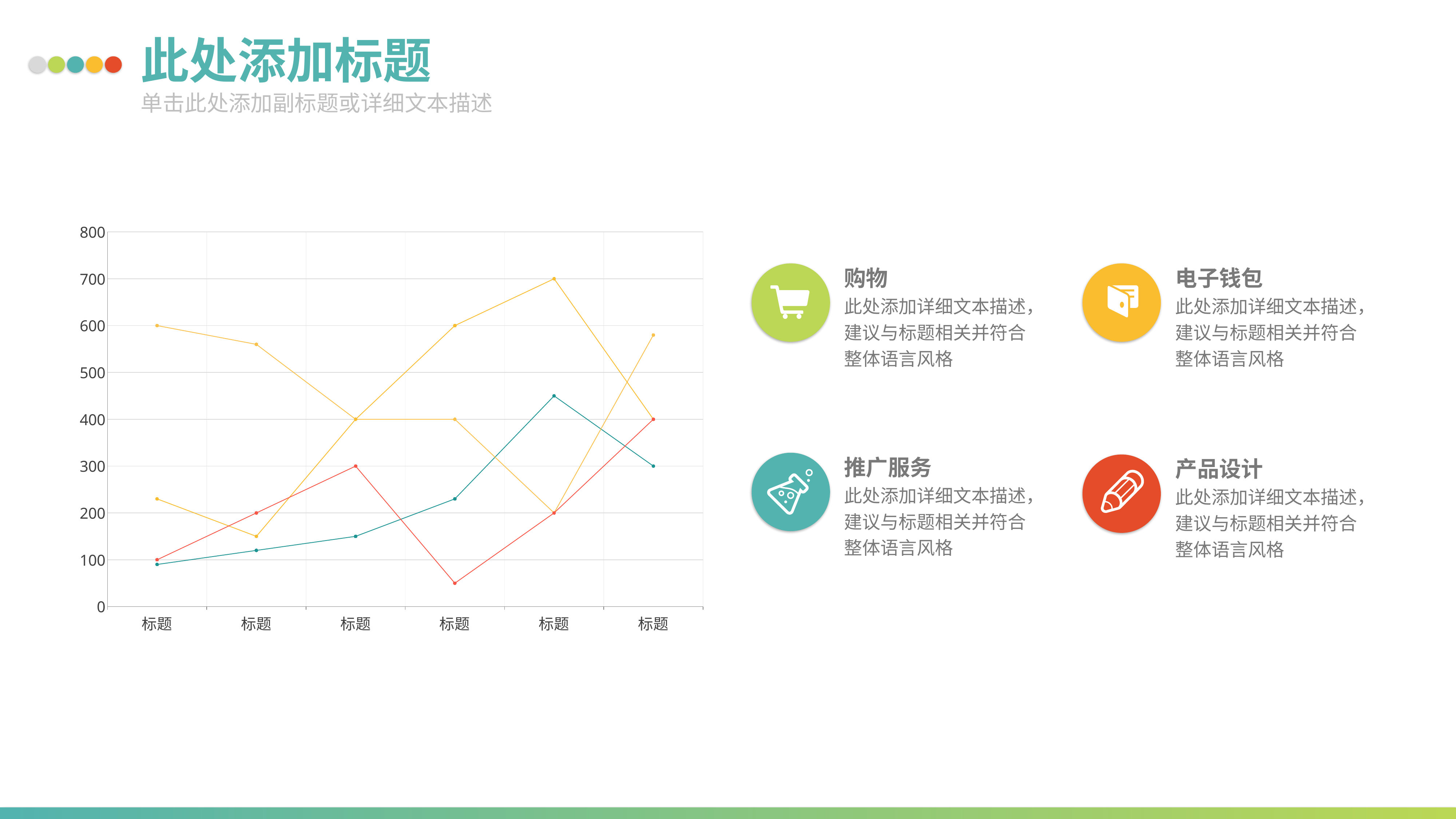
How many lines are plotted on the chart? 4 Is the value of the teal line at the fifth category greater or less than 400? greater What kind of chart is shown on the slide? line chart At the last category, which line has the larger value, the red line or the teal line? the red line Does the teal line rise or fall from the first category to the fifth category? rise Is the value of the teal line at the third category greater or less than 200? less At which category does the teal line reach its highest value? the fifth category Is the value of the red line at the sixth (last) category greater or less than 300? greater At which category does the red line reach its lowest value? the fourth category How many categories are shown along the x axis of the chart? 6 What is the highest value shown on the chart's y axis? 800